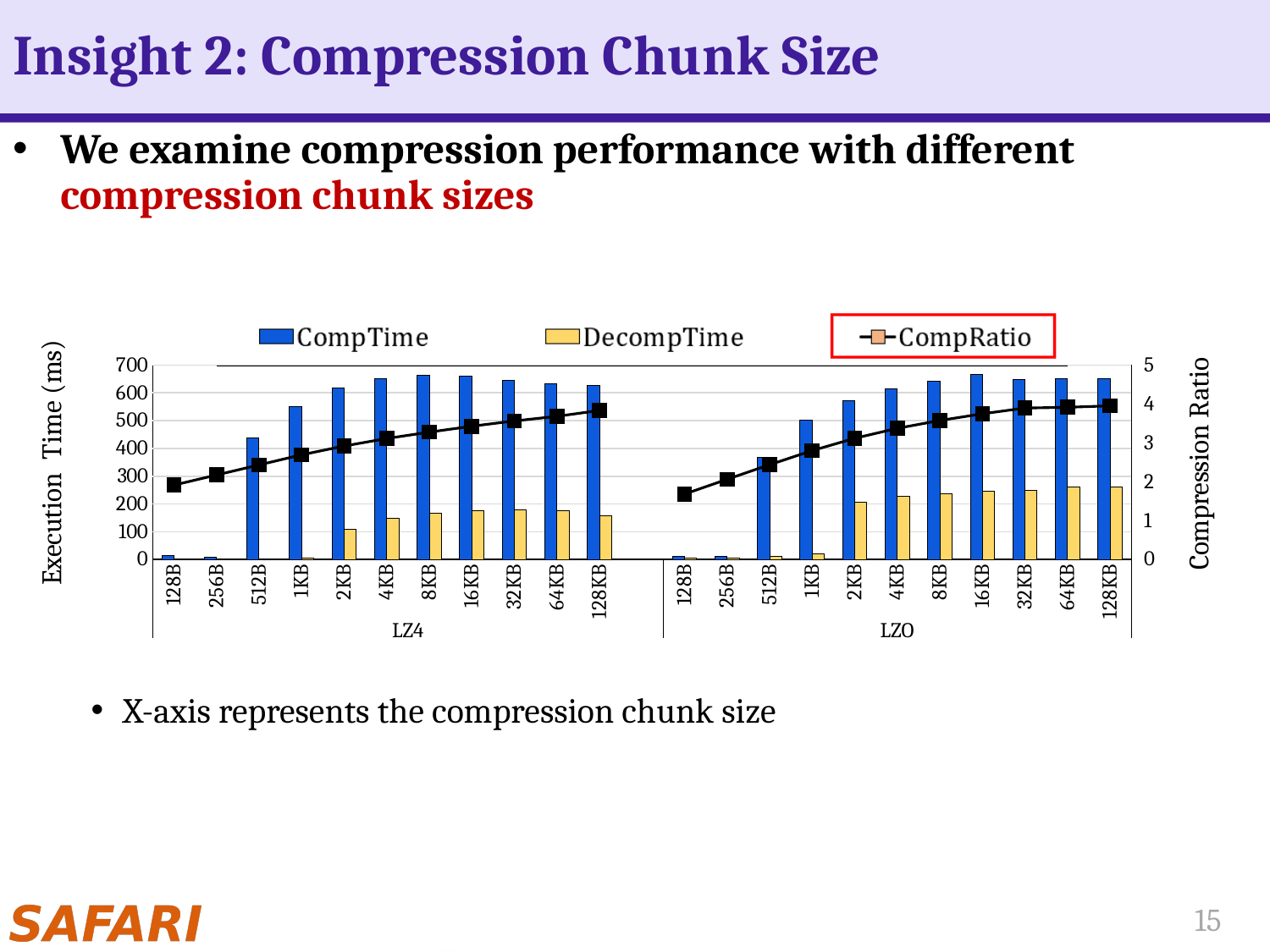
Is the CompTime value for LZ4 at 8KB greater or less than 600? greater What kind of chart is shown on the slide? A combined bar and line chart Is the DecompTime value for LZO at 128KB greater or less than 200? greater Which two compression algorithms are labelled on the x axis? LZ4 and LZO Which legend entry is highlighted with a red box? CompRatio How many compression chunk sizes are shown on the x axis for the LZ4 group? 11 Which is larger, the CompTime for LZ4 at 512B or at 1KB? 1KB Does the CompRatio line rise or fall as the compression chunk size increases within the LZO group? rise Is the CompRatio value for LZ4 at 128KB greater or less than 3? greater How many series does the legend list? 3